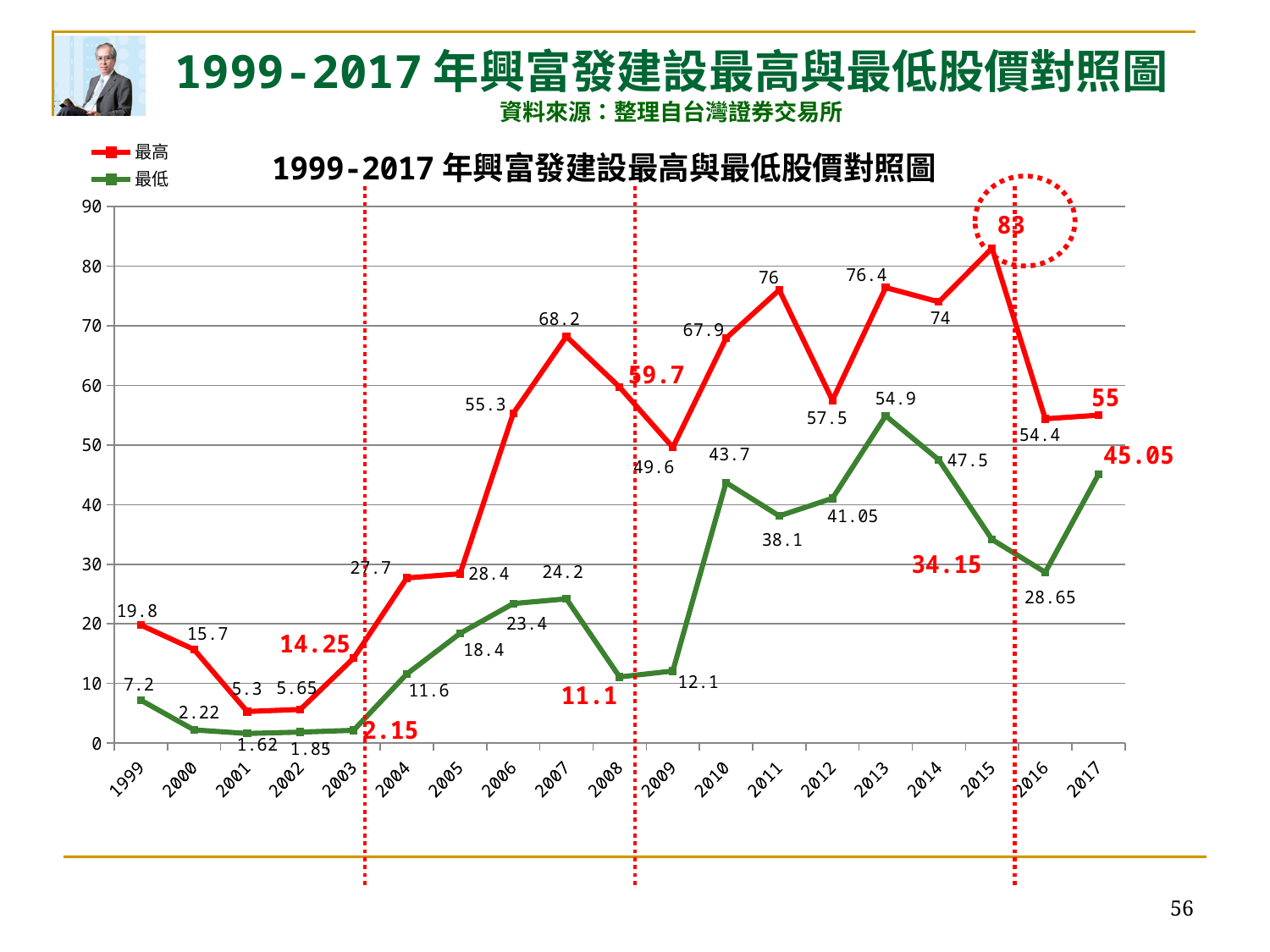
In which year is the 最高 series at its highest? 2015 What is the 最低 value for 2003? 2.15 How many series does the legend list? 2 What is the difference between the 最高 and 最低 values in 2016? 25.75 What is the 最低 value for 2017? 45.05 Which is larger, the 最低 value for 2010 or the 最低 value for 2011? 2010 How many years are plotted on the x axis? 19 What is the 最高 value for 2008? 59.7 Does the 最高 series rise or fall from 2015 to 2016? fall What is the 最高 value for 2015? 83 What kind of chart is shown? line chart In which year is the 最低 series at its lowest? 2001